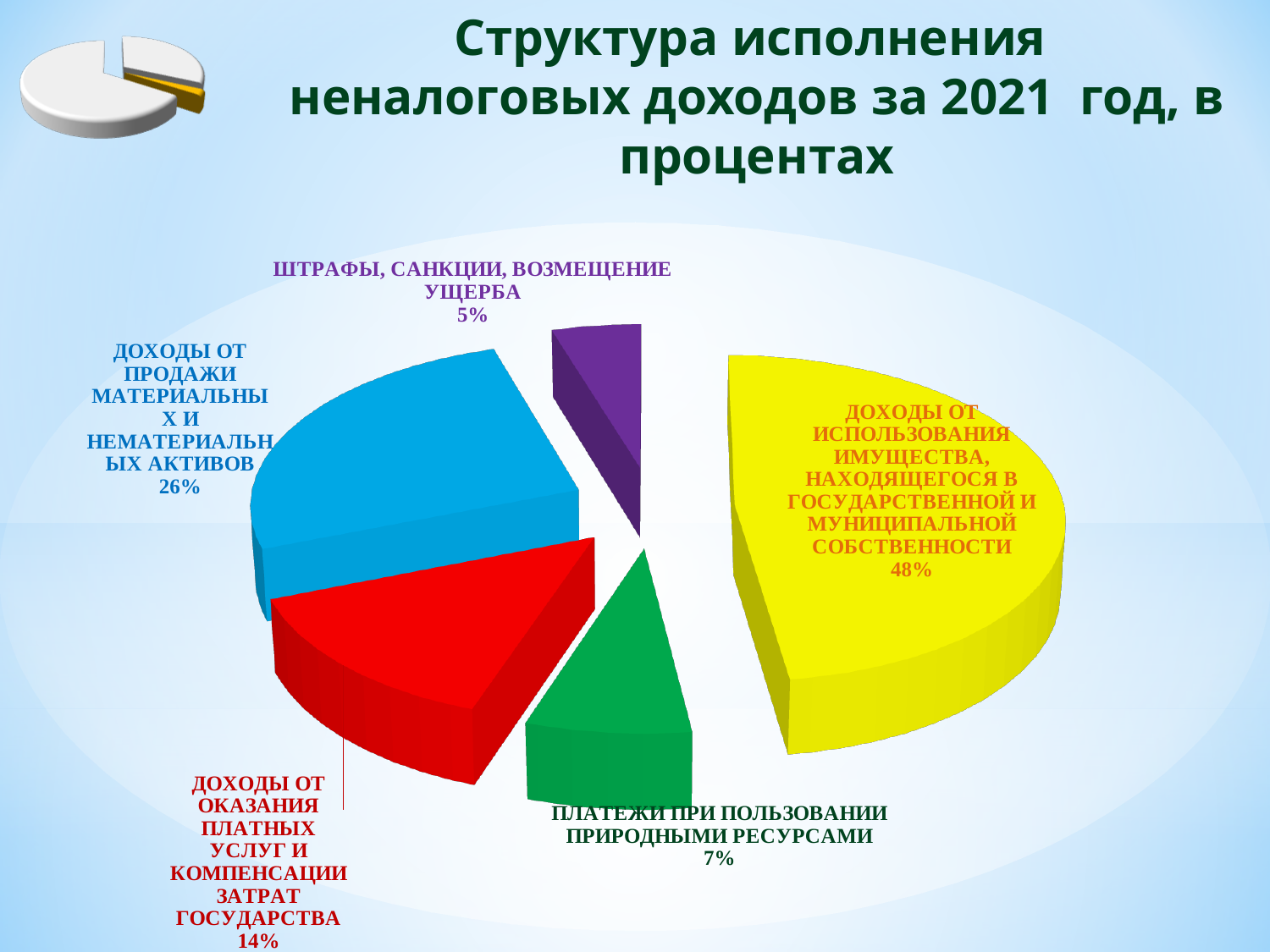
How many slices does the pie chart have? 5 What share of the pie is "ПЛАТЕЖИ ПРИ ПОЛЬЗОВАНИИ ПРИРОДНЫМИ РЕСУРСАМИ"? 7% Which category has the largest share of the pie? ДОХОДЫ ОТ ИСПОЛЬЗОВАНИЯ ИМУЩЕСТВА, НАХОДЯЩЕГОСЯ В ГОСУДАРСТВЕННОЙ И МУНИЦИПАЛЬНОЙ СОБСТВЕННОСТИ Which is larger: the share for "ПЛАТЕЖИ ПРИ ПОЛЬЗОВАНИИ ПРИРОДНЫМИ РЕСУРСАМИ" or for "ШТРАФЫ, САНКЦИИ, ВОЗМЕЩЕНИЕ УЩЕРБА"? ПЛАТЕЖИ ПРИ ПОЛЬЗОВАНИИ ПРИРОДНЫМИ РЕСУРСАМИ Which category has the smallest share of the pie? ШТРАФЫ, САНКЦИИ, ВОЗМЕЩЕНИЕ УЩЕРБА What share of the pie is "ДОХОДЫ ОТ ОКАЗАНИЯ ПЛАТНЫХ УСЛУГ И КОМПЕНСАЦИИ ЗАТРАТ ГОСУДАРСТВА"? 14% What kind of chart is shown on the slide? Pie chart What is the difference in percentage points between "ДОХОДЫ ОТ ПРОДАЖИ МАТЕРИАЛЬНЫХ И НЕМАТЕРИАЛЬНЫХ АКТИВОВ" and "ДОХОДЫ ОТ ОКАЗАНИЯ ПЛАТНЫХ УСЛУГ И КОМПЕНСАЦИИ ЗАТРАТ ГОСУДАРСТВА"? 12% What share of the pie is "ШТРАФЫ, САНКЦИИ, ВОЗМЕЩЕНИЕ УЩЕРБА"? 5% What colour is the slice for "ДОХОДЫ ОТ ИСПОЛЬЗОВАНИЯ ИМУЩЕСТВА, НАХОДЯЩЕГОСЯ В ГОСУДАРСТВЕННОЙ И МУНИЦИПАЛЬНОЙ СОБСТВЕННОСТИ"? Yellow